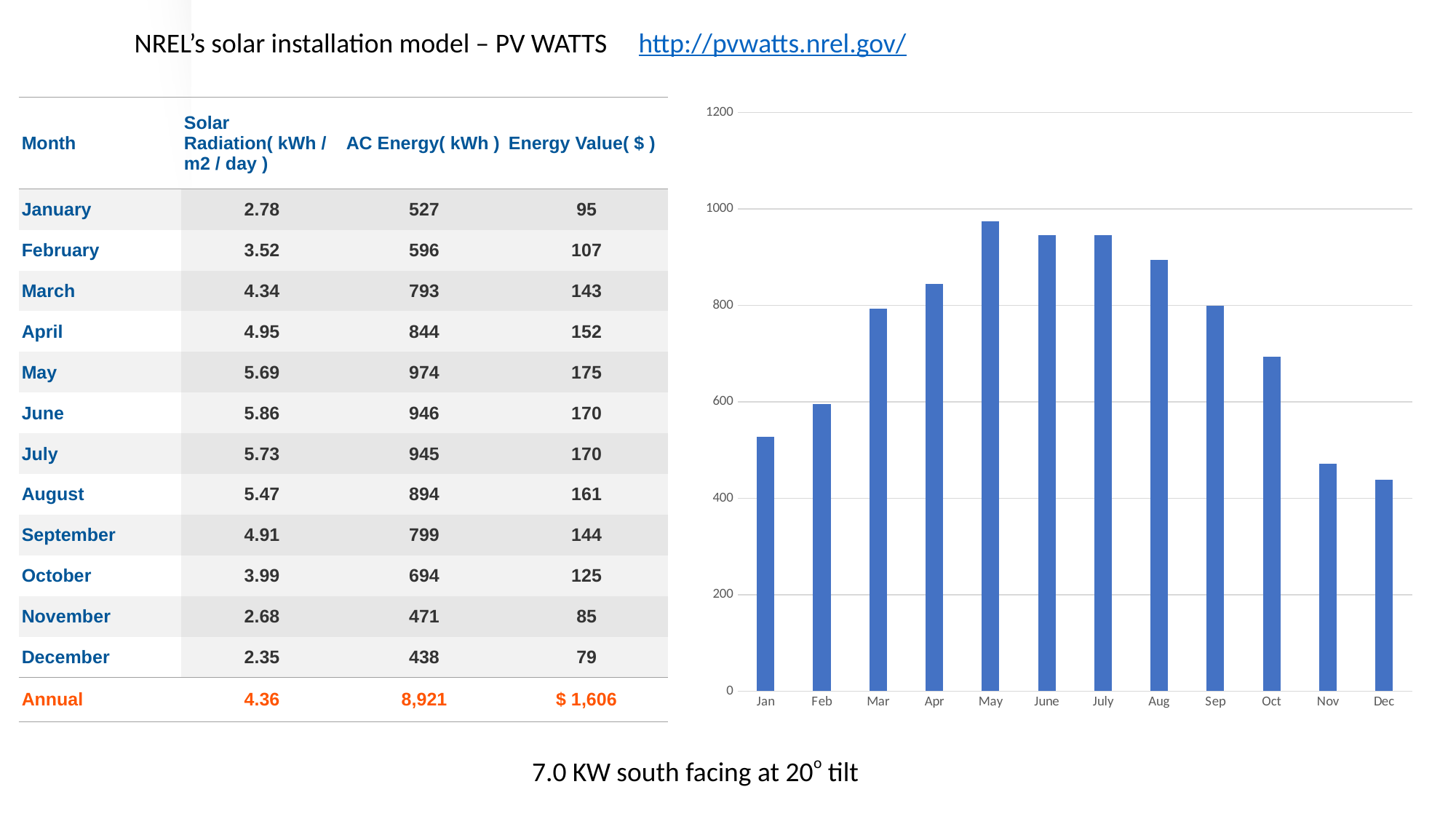
Which month has the tallest bar on the chart? May How many months are plotted on the bar chart? 12 Which month has the shortest bar on the chart? Dec Is the bar for May greater or less than 1000? less What kind of chart is shown on the right of the slide? bar chart Is the bar for Jan greater or less than 600? less Which bar is taller, Jan or Feb? Feb Is the bar for Apr greater or less than 800? greater Which bar is taller, Oct or Nov? Oct Do the bars rise or fall from May through Dec? fall